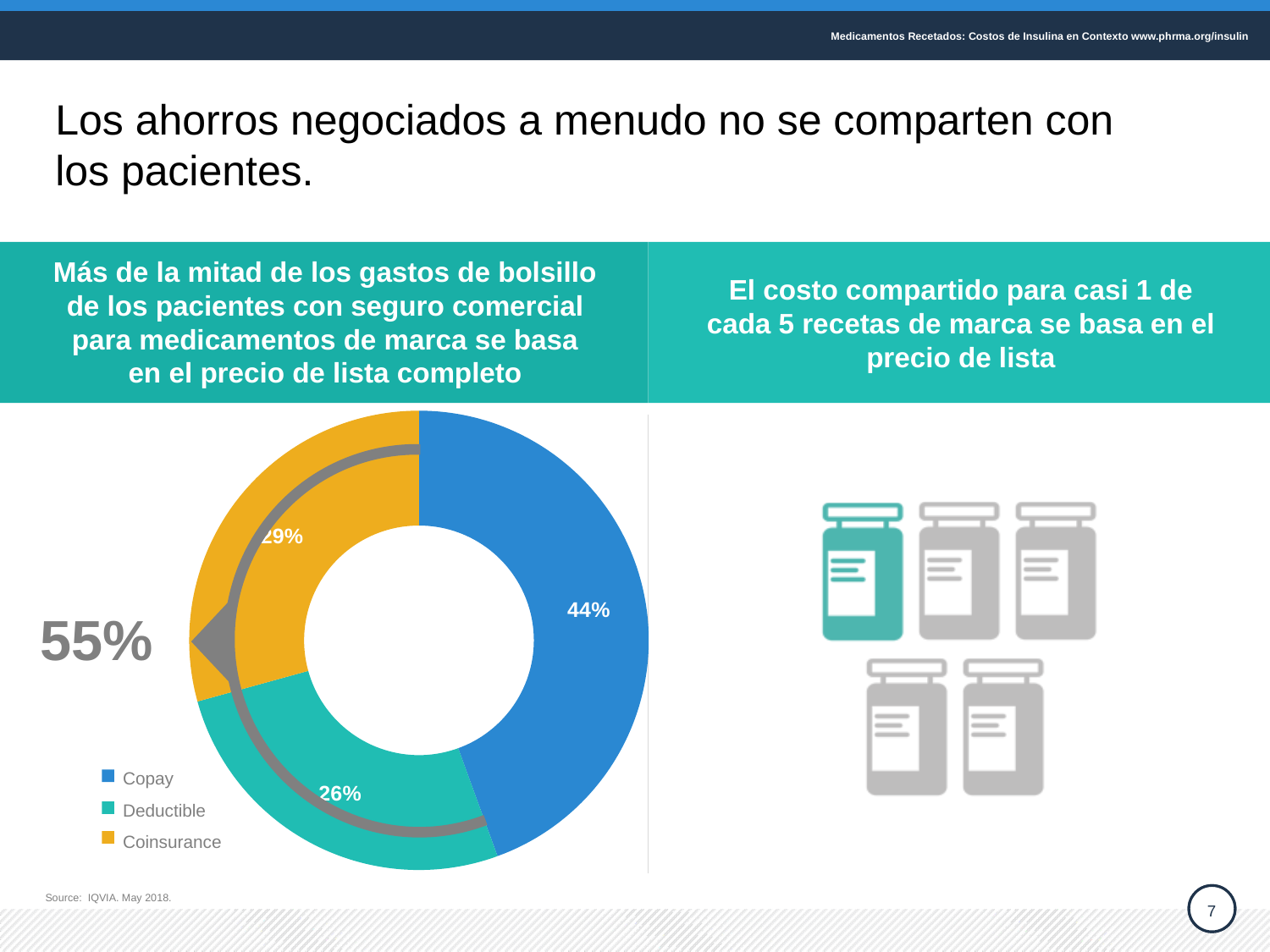
Which category has the smallest slice in the donut chart? Deductible What kind of chart is shown on the left side of the slide? Pie chart (donut) What is the combined share of the Deductible and Coinsurance slices, as highlighted next to the donut chart? 55% How many slices does the donut chart have? 3 What percentage does the Copay slice represent in the donut chart? 44% Which category has the largest slice in the donut chart? Copay What colour is used for the Copay slice in the donut chart? Blue What percentage does the Coinsurance slice represent in the donut chart? 29% Which slice is larger in the donut chart, Coinsurance or Deductible? Coinsurance What is the difference in percentage points between the Copay slice and the Deductible slice? 18 percentage points How many entries does the legend of the donut chart list? 3 What percentage does the Deductible slice represent in the donut chart? 26%